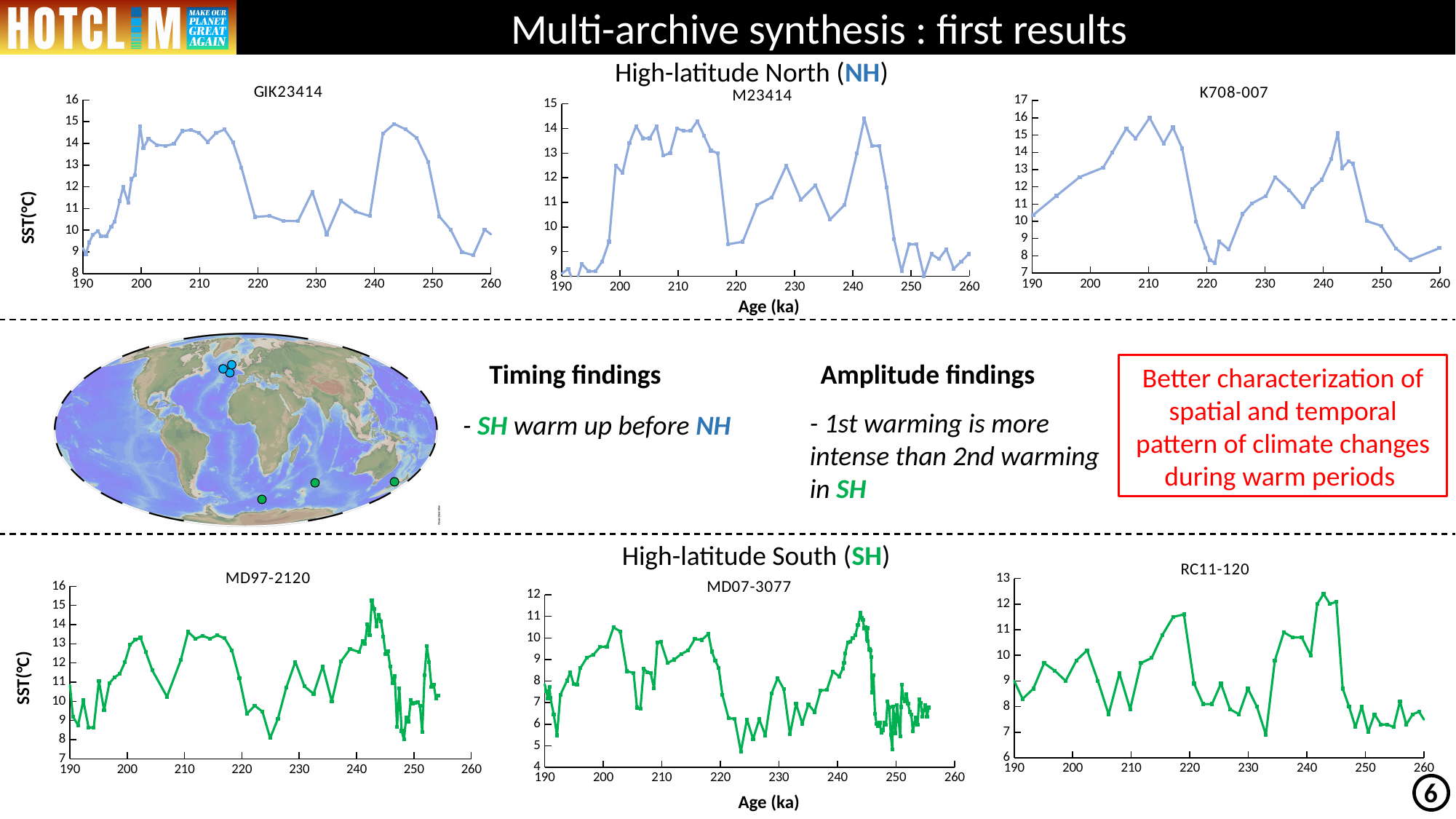
In the K708-007 chart, does the SST rise or fall between 190 ka and 210 ka? rise In the MD97-2120 chart, is the SST value at 225 ka greater or less than 9? less What kind of chart is the GIK23414 chart in the High-latitude North section? line chart In the MD07-3077 chart, is the SST value at 223 ka greater or less than 6? less In the GIK23414 chart, is the SST value at 200 ka greater or less than 12? greater What is the y-axis label on the GIK23414 chart? SST(°C) How many charts are shown in the High-latitude South (SH) section of the slide? 3 What is the x-axis label shown under the M23414 chart? Age (ka)